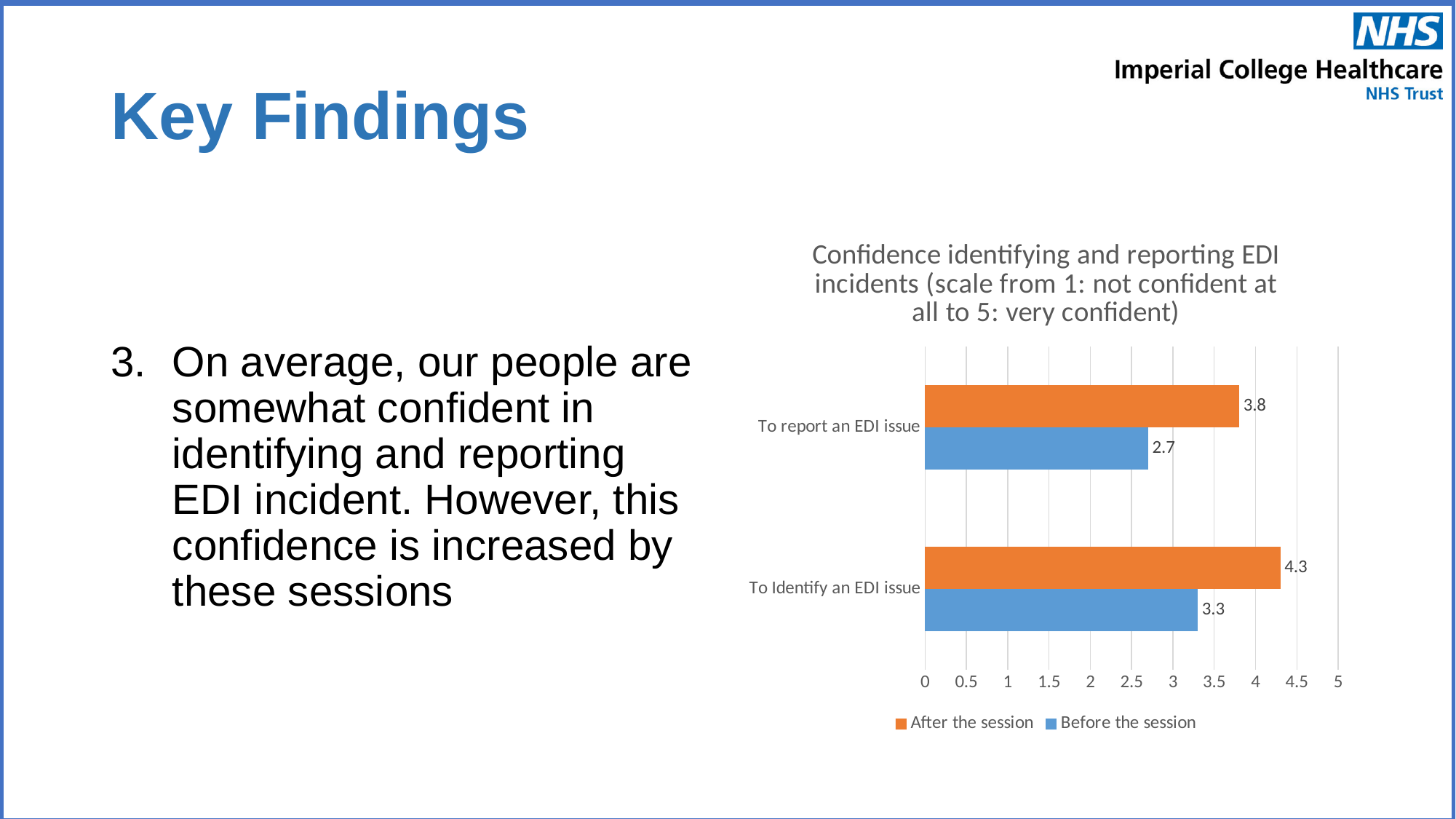
Which category has the lowest "Before the session" value? To report an EDI issue What is the difference between the "After the session" and "Before the session" values for "To report an EDI issue"? 1.1 What is the value for "After the session" for "To report an EDI issue"? 3.8 Which category has the highest "After the session" value? To Identify an EDI issue What is the value for "Before the session" for "To report an EDI issue"? 2.7 How many series does the legend list? 2 What kind of chart is shown on the slide? Bar chart How many categories are shown on the chart? 2 What is the difference between the "After the session" and "Before the session" values for "To Identify an EDI issue"? 1.0 Is the "After the session" value for "To Identify an EDI issue" greater or less than 4? greater What is the value for "Before the session" for "To Identify an EDI issue"? 3.3 Which is larger for "To report an EDI issue": the "After the session" value or the "Before the session" value? After the session